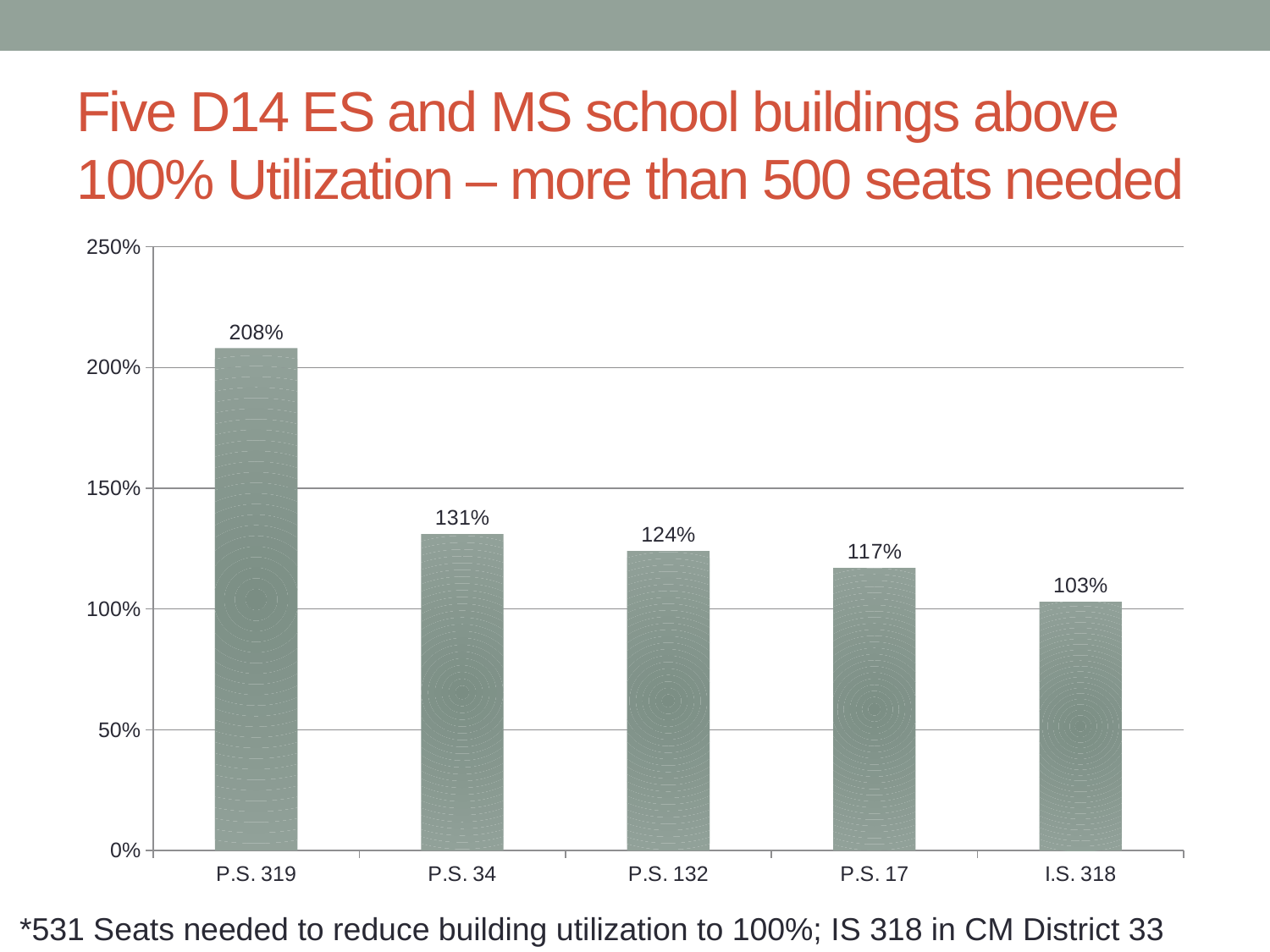
Which school building has the highest utilization? P.S. 319 Which school building has the lowest utilization? I.S. 318 Is the value for P.S. 319 greater or less than 200%? greater How many school buildings are shown in the chart? 5 What is the utilization value for I.S. 318? 103% Which has a higher utilization, P.S. 34 or P.S. 17? P.S. 34 Do the values rise or fall from left to right across the x axis? fall What is the utilization value for P.S. 132? 124% What is the difference in utilization between P.S. 319 and P.S. 34? 77% What is the difference in utilization between P.S. 17 and I.S. 318? 14% What is the utilization value for P.S. 319? 208% What kind of chart is shown on the slide? bar chart